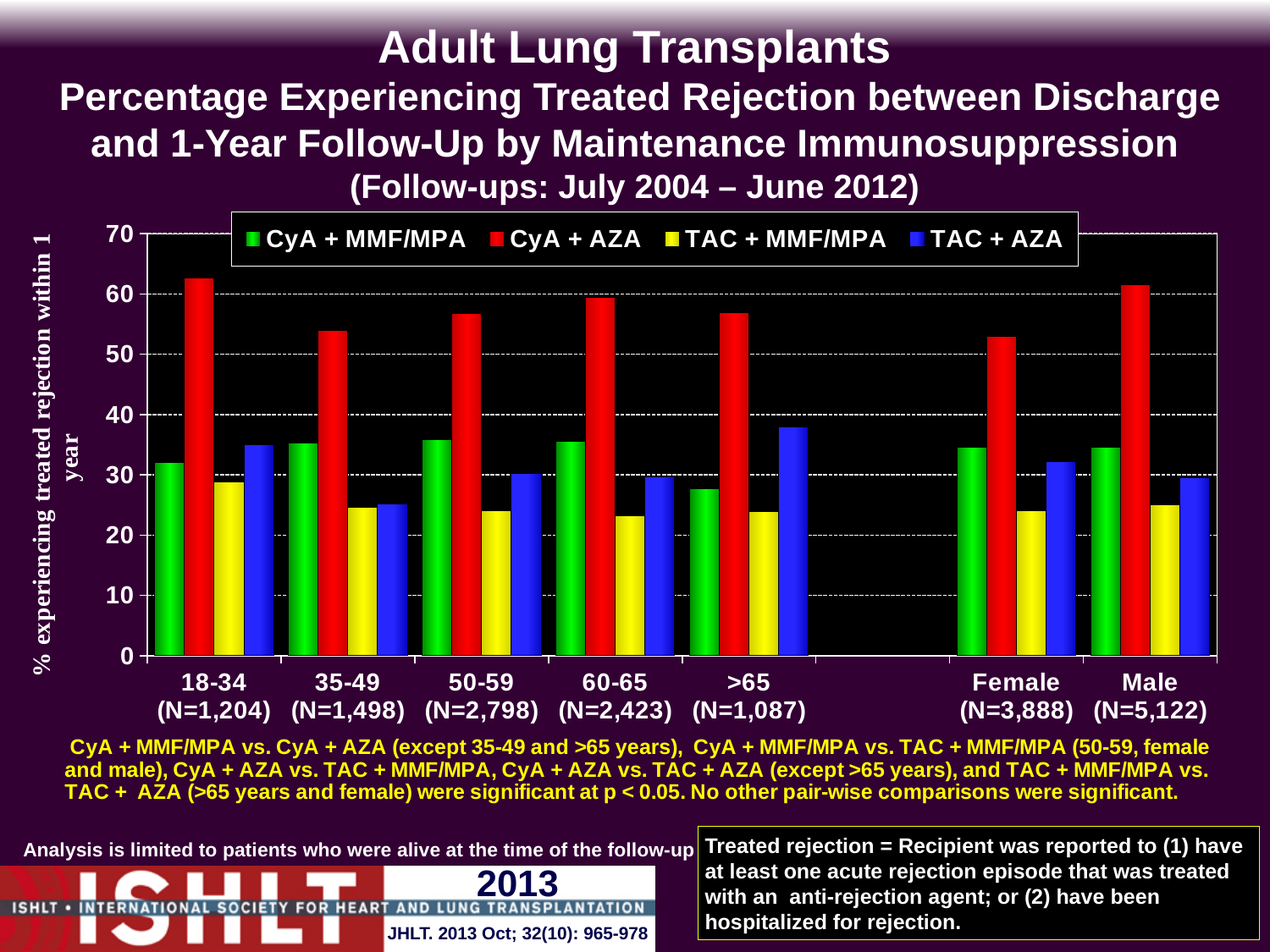
Is the value for CyA + AZA in the 18-34 age group greater or less than 60? greater Which immunosuppression regimen has the highest percentage in the 18-34 age group? CyA + AZA Is the value for TAC + AZA in the Female group greater or less than 30? greater In the 50-59 age group, which is larger: TAC + AZA or TAC + MMF/MPA? TAC + AZA Which age group has the lowest value for CyA + MMF/MPA? >65 What kind of chart is shown on the slide? bar chart How many categories are shown along the x axis? 7 Is the value for CyA + AZA in the Male group greater or less than 60? greater What colour represents TAC + AZA in the legend? blue In the >65 age group, which is larger: TAC + AZA or CyA + MMF/MPA? TAC + AZA How many series does the legend list? 4